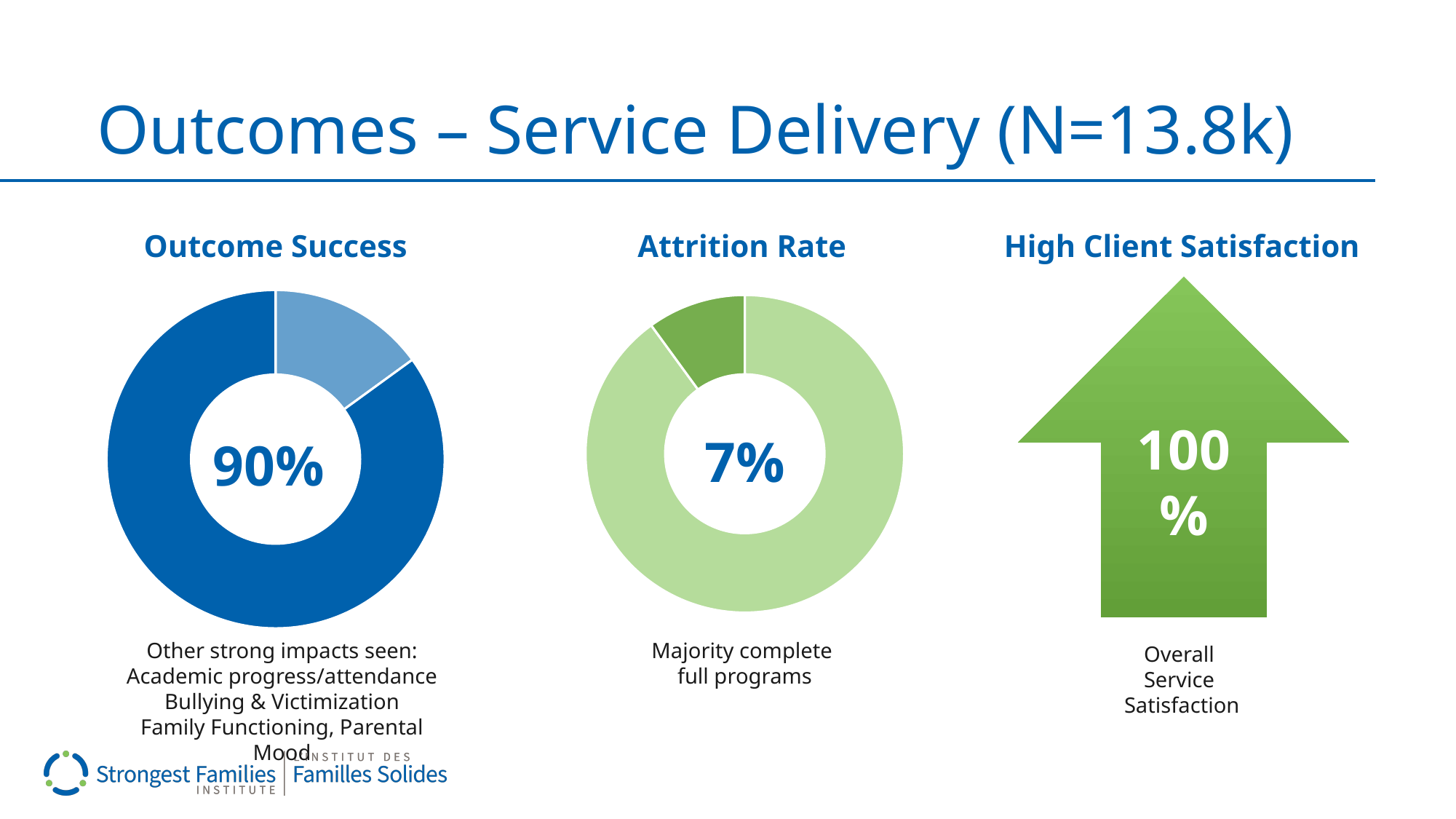
What percentage is shown on the High Client Satisfaction arrow graphic? 100% What colour is the largest slice of the Attrition Rate donut chart? Light green How many donut charts are on the slide? 2 In the Outcome Success donut chart, is the light blue slice larger or smaller than the dark blue portion? Smaller In the Attrition Rate donut chart, is the dark green slice larger or smaller than the light green slice? Smaller What is the difference between the Outcome Success value (90%) and the Attrition Rate value (7%)? 83% What value is shown in the centre of the Outcome Success donut chart? 90% What kind of chart is used for Outcome Success? Donut (pie) chart What is the title of the left-hand donut chart? Outcome Success Which is larger, the Outcome Success value or the Attrition Rate value? Outcome Success What kind of chart is used for Attrition Rate? Donut (pie) chart What value is shown in the centre of the Attrition Rate donut chart? 7%